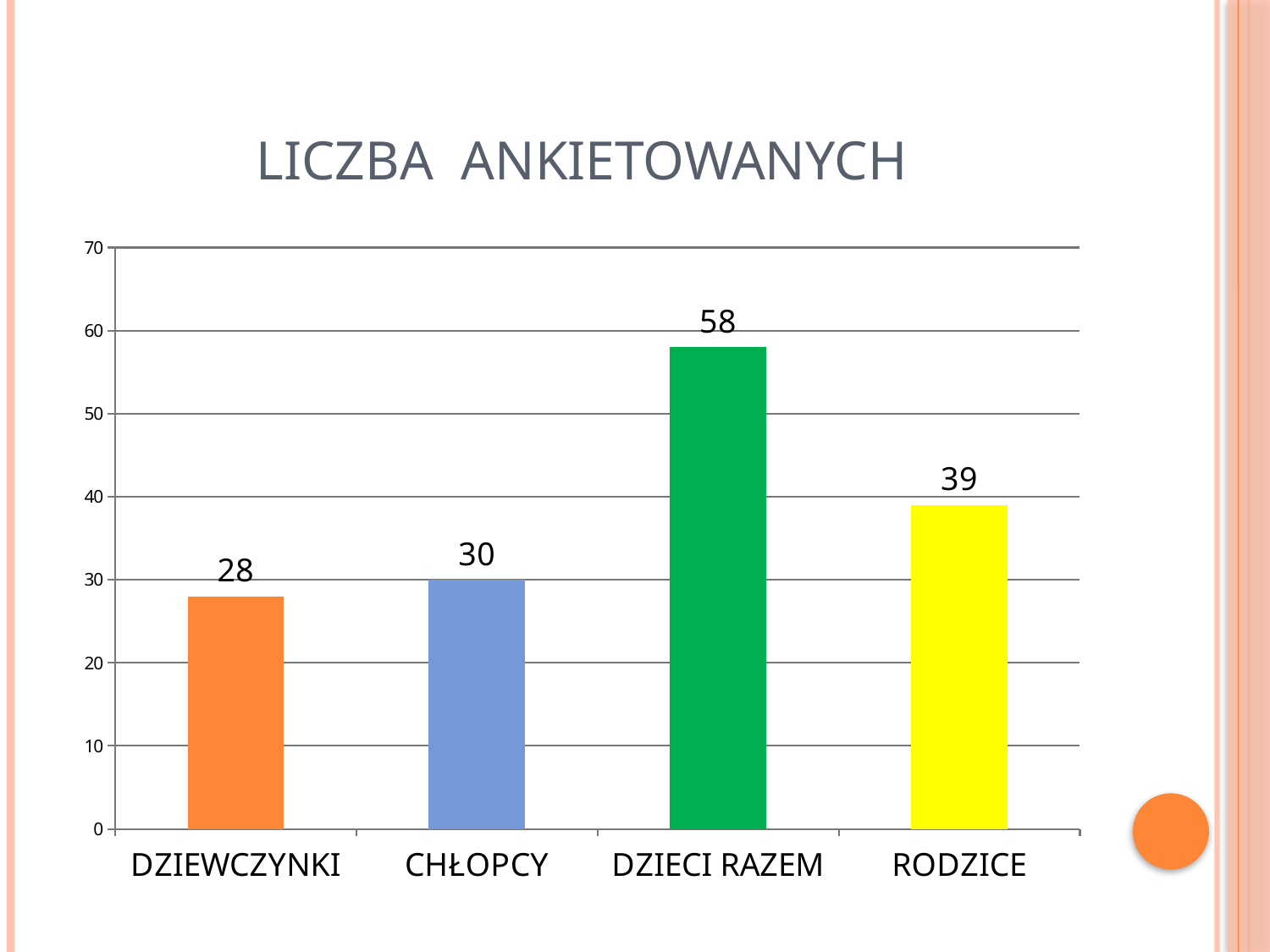
What is the value for DZIECI RAZEM? 58 What kind of chart is shown on the slide? bar chart What is the difference between the values for DZIECI RAZEM and RODZICE? 19 What is the value for RODZICE? 39 What is the difference between the values for CHŁOPCY and DZIEWCZYNKI? 2 How many categories are shown on the x axis? 4 Which category has the lowest value? DZIEWCZYNKI What is the value for CHŁOPCY? 30 What is the value for DZIEWCZYNKI? 28 Which category has the highest value? DZIECI RAZEM Is the value for RODZICE greater or less than 40? less Which is larger, the value for RODZICE or the value for CHŁOPCY? RODZICE